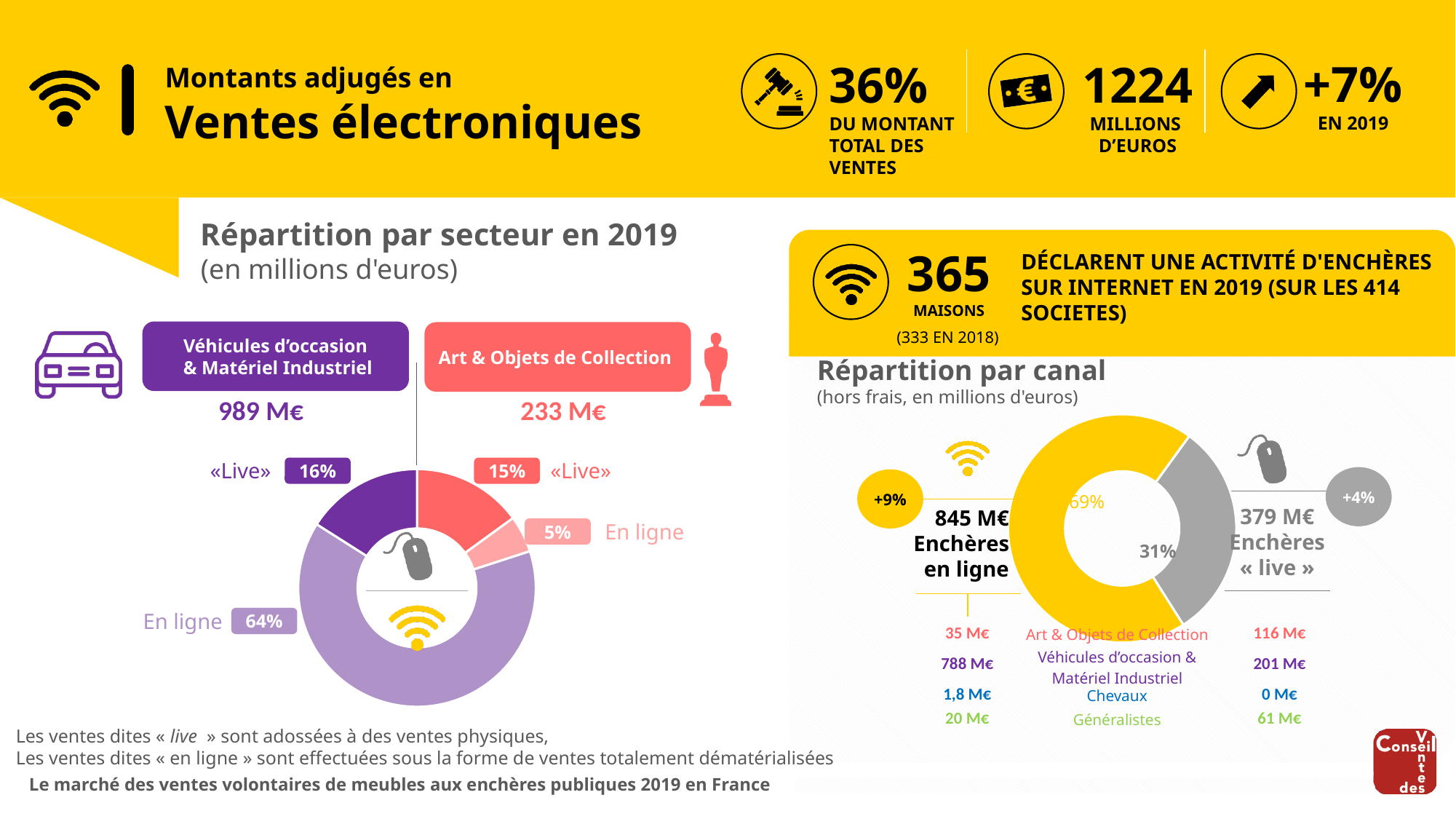
In the 'Répartition par secteur en 2019' chart, what share is labelled for 'En ligne' in the Véhicules d'occasion & Matériel Industriel sector? 64% In the 'Répartition par canal' chart, what amount is shown for 'Enchères « live »'? 379 M€ In the 'Répartition par canal' chart, which is larger: Enchères en ligne or Enchères « live »? Enchères en ligne In the 'Répartition par canal' chart, how many segments does the donut have? 2 In the 'Répartition par secteur en 2019' chart, which segment has the smallest share? En ligne (Art & Objets de Collection), 5% In the 'Répartition par secteur en 2019' chart, what is the total amount shown for Véhicules d'occasion & Matériel Industriel? 989 M€ In the 'Répartition par secteur en 2019' chart, what share is labelled for '«Live»' in the Art & Objets de Collection sector? 15% In the 'Répartition par canal' chart, what share is shown for 'Enchères en ligne'? 69% In the 'Répartition par secteur en 2019' chart, which segment has the largest share? En ligne (Véhicules d'occasion & Matériel Industriel), 64% In the 'Répartition par secteur en 2019' chart, what is the difference in percentage points between the '«Live»' shares of the two sectors (16% and 15%)? 1 percentage point What type of chart is used for 'Répartition par canal'? Donut (pie) chart In the 'Répartition par canal' chart, what is the 'Enchères en ligne' amount for Véhicules d'occasion & Matériel Industriel? 788 M€